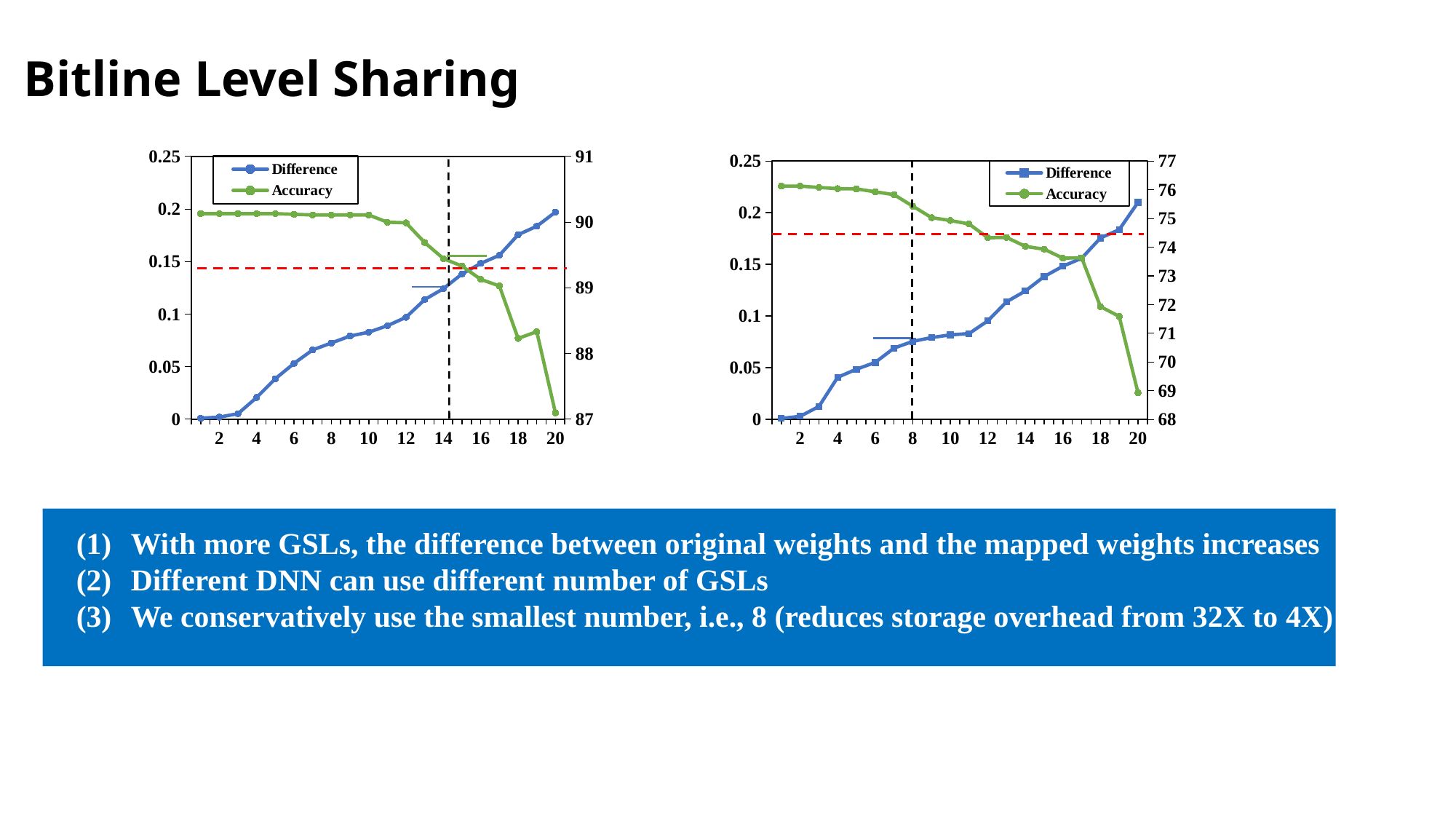
In the left chart, is the Accuracy value at x = 2 greater or less than 89? greater In the right chart, is the Accuracy value at x = 20 greater or less than 70? less In the right chart, is the Difference value larger at x = 4 or at x = 16? x = 16 In the right chart, does the Accuracy series rise or fall as the x-axis value increases? fall What is the highest tick label on the right-hand vertical axis of the right chart? 77 What are the two series named in the legend of the right chart? Difference and Accuracy What kind of chart is the left chart? line chart In the left chart, is the Difference value at x = 20 greater or less than 0.15? greater How many series does the legend of the left chart list? 2 In the left chart, does the Difference series rise or fall as the x-axis value increases? rise